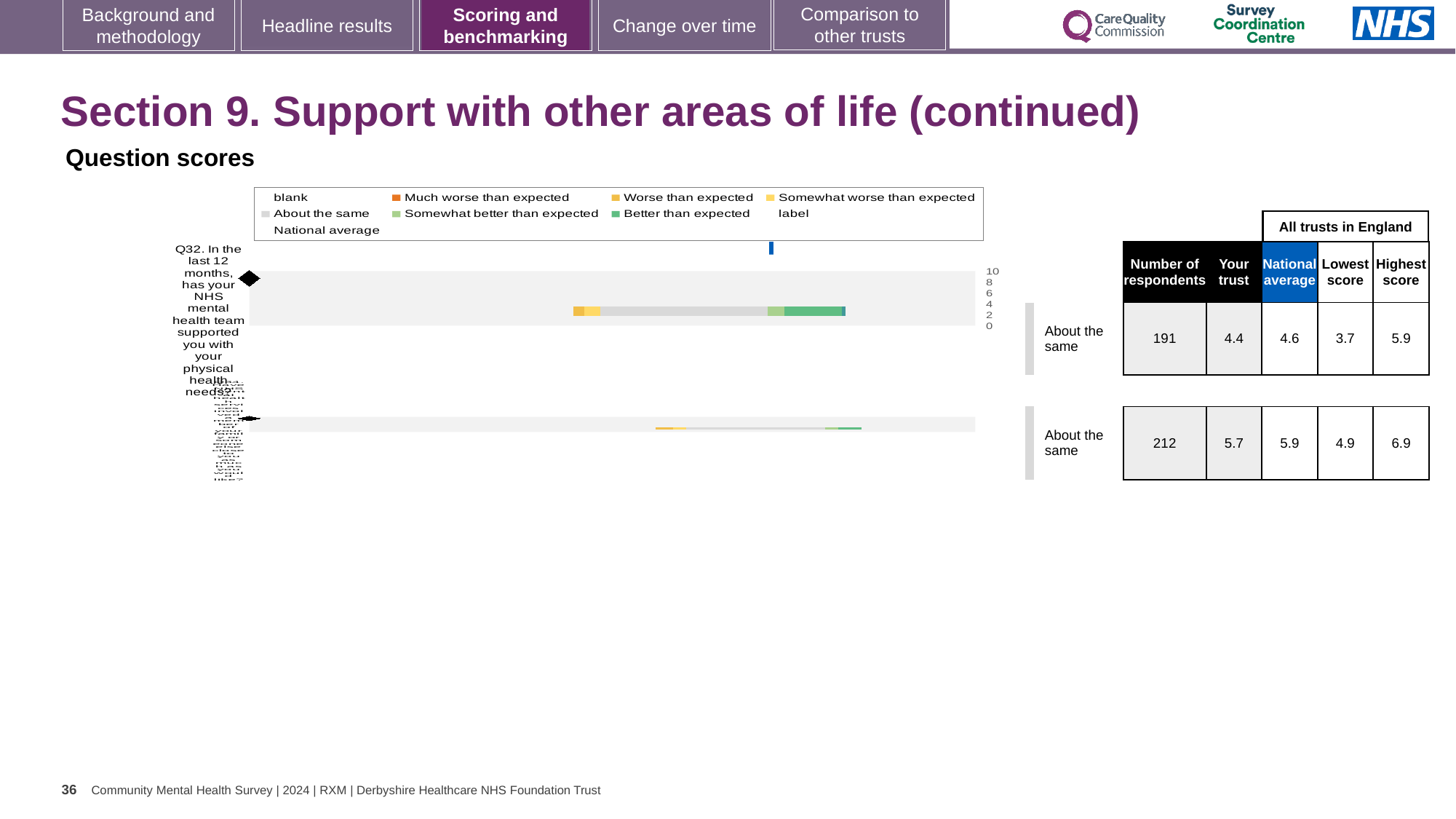
How many respondents answered Q32 according to the table? 191 Is the trust's score for Q32 greater or less than 6 on the chart's axis? less What kind of chart is used to show the question scores? bar chart For Q32, what is the difference between the highest and lowest scores among all trusts in England? 2.2 For Q32, is the trust's score higher or lower than the national average? lower For Q32, how much lower is the trust's score than the national average? 0.2 What is the highest score among all trusts in England for Q32? 5.9 What is the 'Your trust' score for Q32? 4.4 How many question rows are plotted on the chart? 2 What is the lowest score among all trusts in England for Q32? 3.7 What is the national average score for Q32? 4.6 Which benchmarking category is the trust's Q32 score placed in? About the same